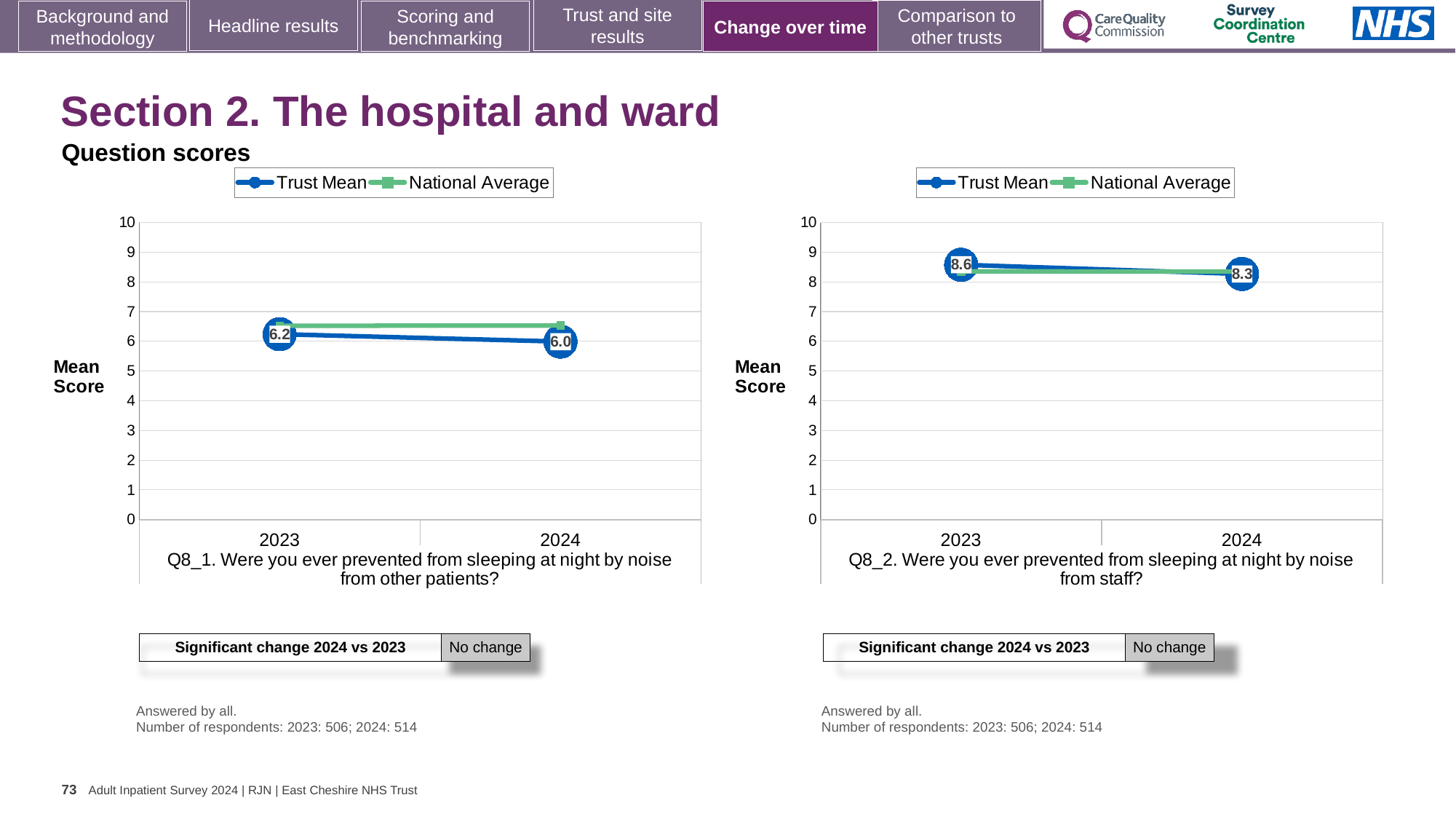
In the Q8_1 chart (noise from other patients), what is the Trust Mean score for 2024? 6.0 What kind of chart is used on the left of the slide for Q8_1? line chart In the Q8_2 chart, what is the difference between the Trust Mean in 2023 and in 2024? 0.3 In the Q8_2 chart (noise from staff), what is the Trust Mean score for 2023? 8.6 In the Q8_2 chart, does the Trust Mean rise or fall from 2023 to 2024? fall In the Q8_2 chart (noise from staff), what is the Trust Mean score for 2024? 8.3 In the Q8_1 chart, is the National Average for 2024 greater or less than 6? greater How many series does the legend of the Q8_1 chart list? 2 In the Q8_1 chart for 2024, which is higher: the Trust Mean or the National Average? National Average In the Q8_1 chart (noise from other patients), what is the Trust Mean score for 2023? 6.2 In the Q8_1 chart, by how much did the Trust Mean change from 2023 to 2024? 0.2 How many years are plotted on the x axis of the Q8_2 chart? 2